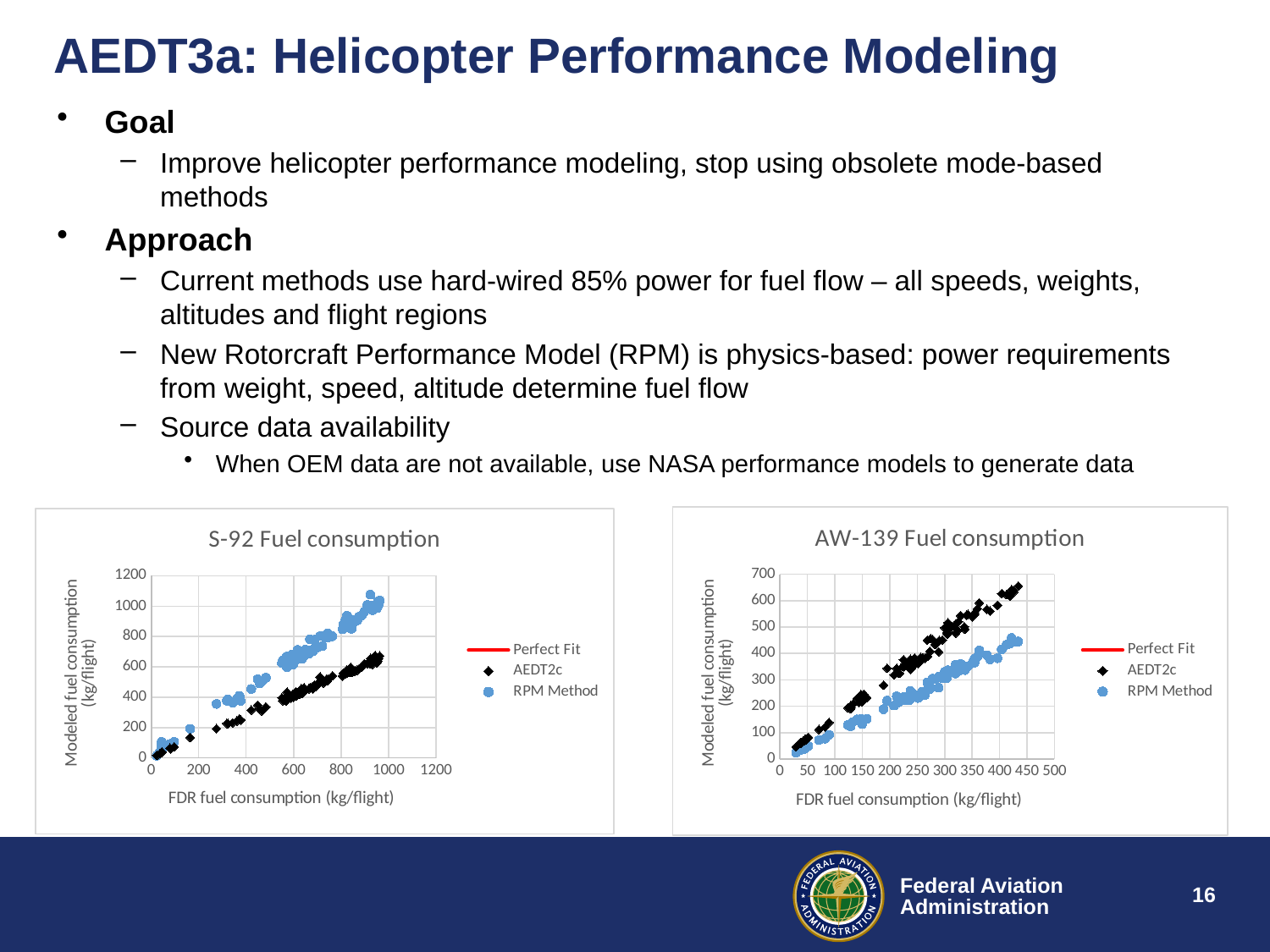
How many series does the legend of the AW-139 Fuel consumption chart list? 3 What kind of chart is the S-92 Fuel consumption chart? scatter chart In the S-92 Fuel consumption chart, do the modeled values rise or fall as FDR fuel consumption increases? rise In the AW-139 Fuel consumption chart, do the modeled values rise or fall as FDR fuel consumption increases? rise In the AW-139 Fuel consumption chart, is the highest RPM Method modeled value greater or less than 500? less In the AW-139 Fuel consumption chart, is the highest AEDT2c modeled value greater or less than 600? greater What is the x-axis title of the AW-139 Fuel consumption chart? FDR fuel consumption (kg/flight) In the S-92 Fuel consumption chart, which series has the higher modeled fuel consumption at a given FDR value, AEDT2c or RPM Method? RPM Method In the S-92 Fuel consumption chart, is the highest AEDT2c modeled value greater or less than 800? less What are the legend entries in the S-92 Fuel consumption chart? Perfect Fit, AEDT2c, RPM Method In the AW-139 Fuel consumption chart, which series has the higher modeled fuel consumption at a given FDR value, AEDT2c or RPM Method? AEDT2c